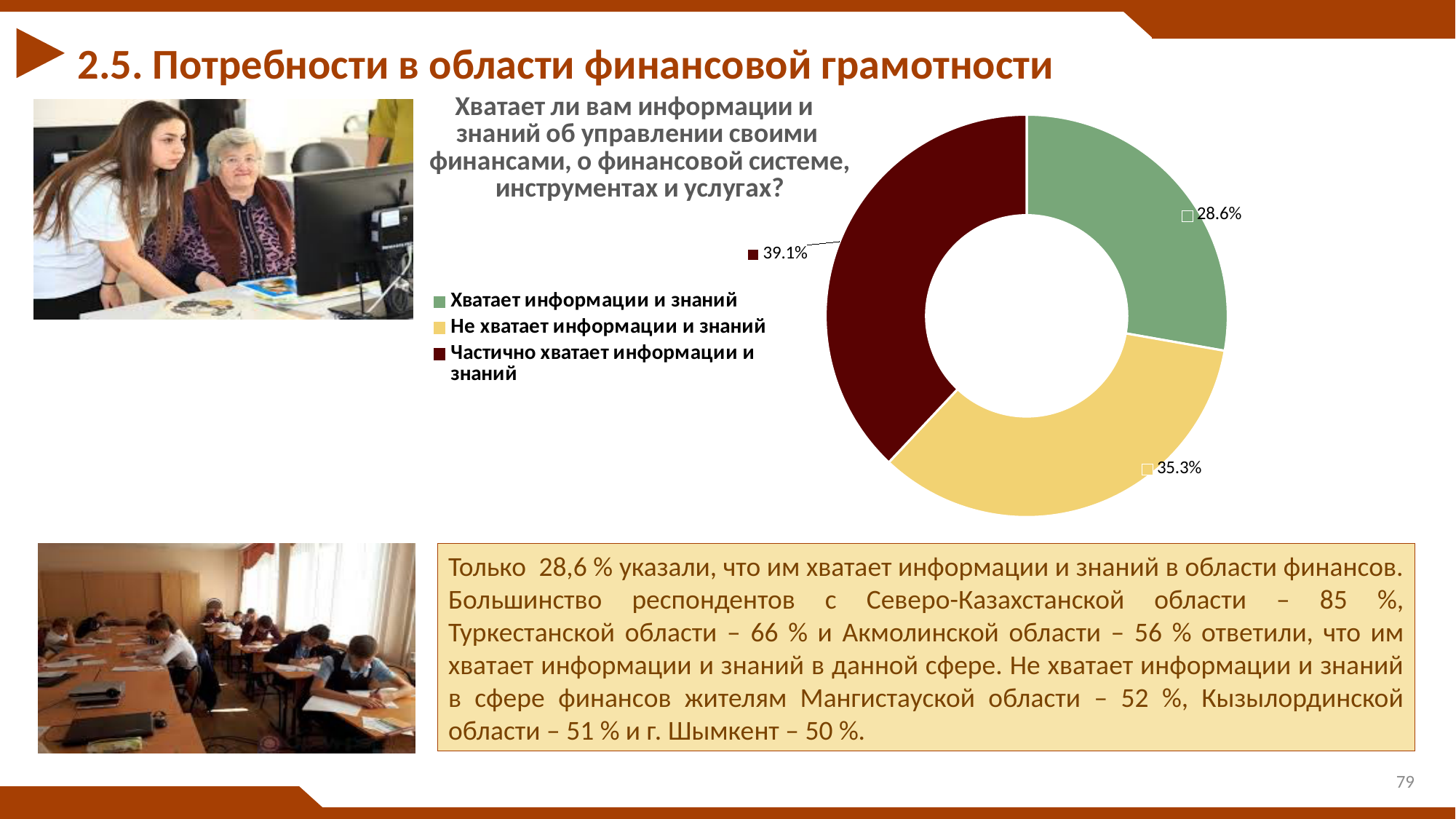
Which colour represents "Частично хватает информации и знаний" in the chart? Dark red How many categories does the chart show? 3 What share of respondents answered "Частично хватает информации и знаний"? 39.1% Which response category has the largest share in the chart? Частично хватает информации и знаний What is the difference in percentage points between "Частично хватает информации и знаний" and "Хватает информации и знаний"? 10.5 Which is larger: the share for "Не хватает информации и знаний" or the share for "Хватает информации и знаний"? Не хватает информации и знаний Which response category has the smallest share in the chart? Хватает информации и знаний What share of respondents answered "Хватает информации и знаний"? 28.6% What is the difference in percentage points between "Не хватает информации и знаний" and "Хватает информации и знаний"? 6.7 What is the title of the chart? Хватает ли вам информации и знаний об управлении своими финансами, о финансовой системе, инструментах и услугах? What kind of chart is shown on the slide? Doughnut (pie) chart What share of respondents answered "Не хватает информации и знаний"? 35.3%